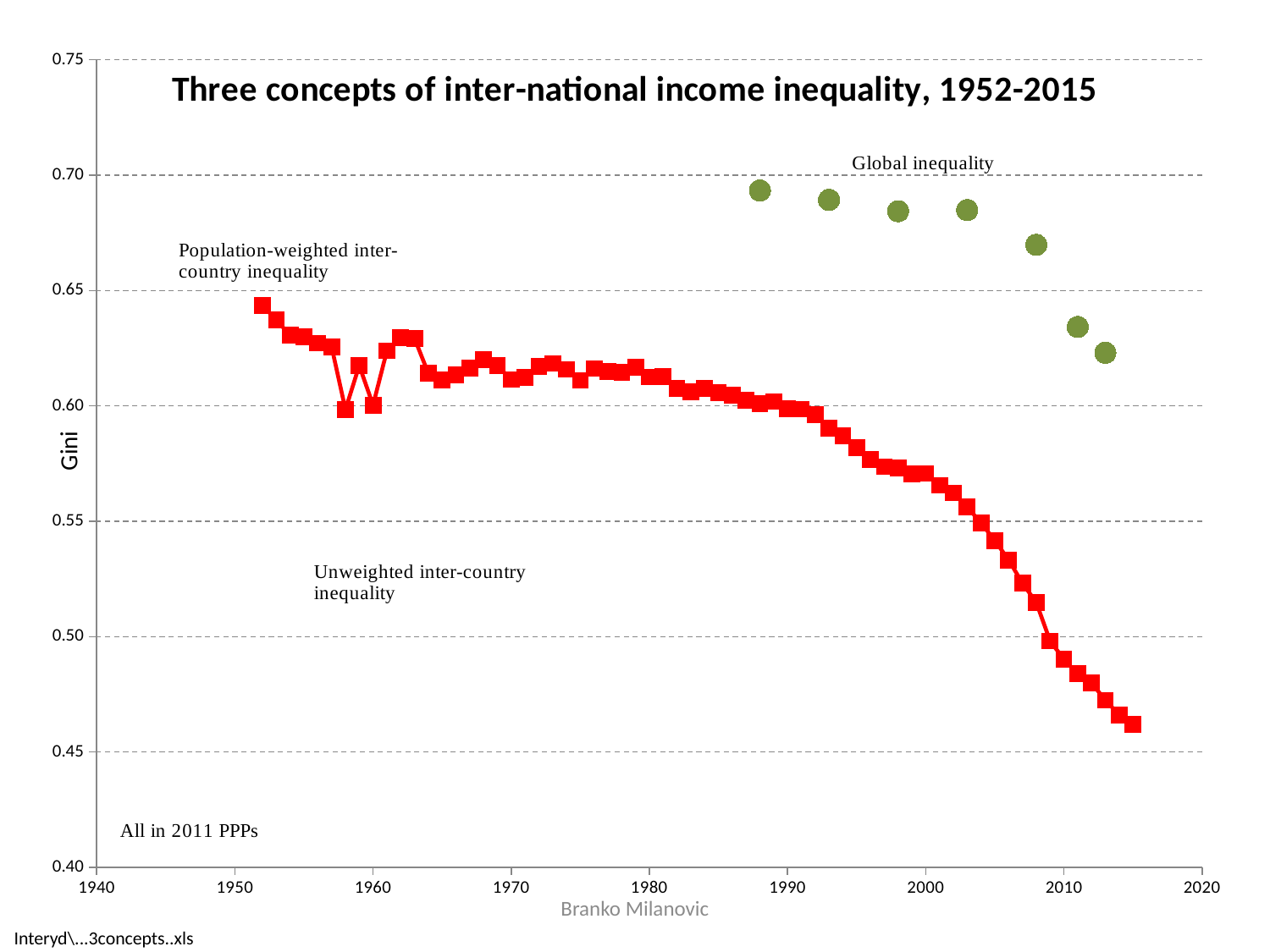
Is the last 'Global inequality' point (around 2013) greater or less than 0.65? less Is the first 'Global inequality' point (around 1988) greater or less than 0.65? greater What is the title of the chart? Three concepts of inter-national income inequality, 1952-2015 Do the green 'Global inequality' points rise or fall from 1988 to 2013? fall How many green 'Global inequality' points are plotted on the chart? 7 Is the red series value around 2000 greater or less than 0.60? less Does the red inter-country inequality series rise or fall overall from 1952 to 2015? fall Around 1988, which is higher: the 'Global inequality' point or the red inter-country inequality series? Global inequality What is the label on the vertical axis of the chart? Gini Which 'Global inequality' point is the lowest? The last one (around 2013)